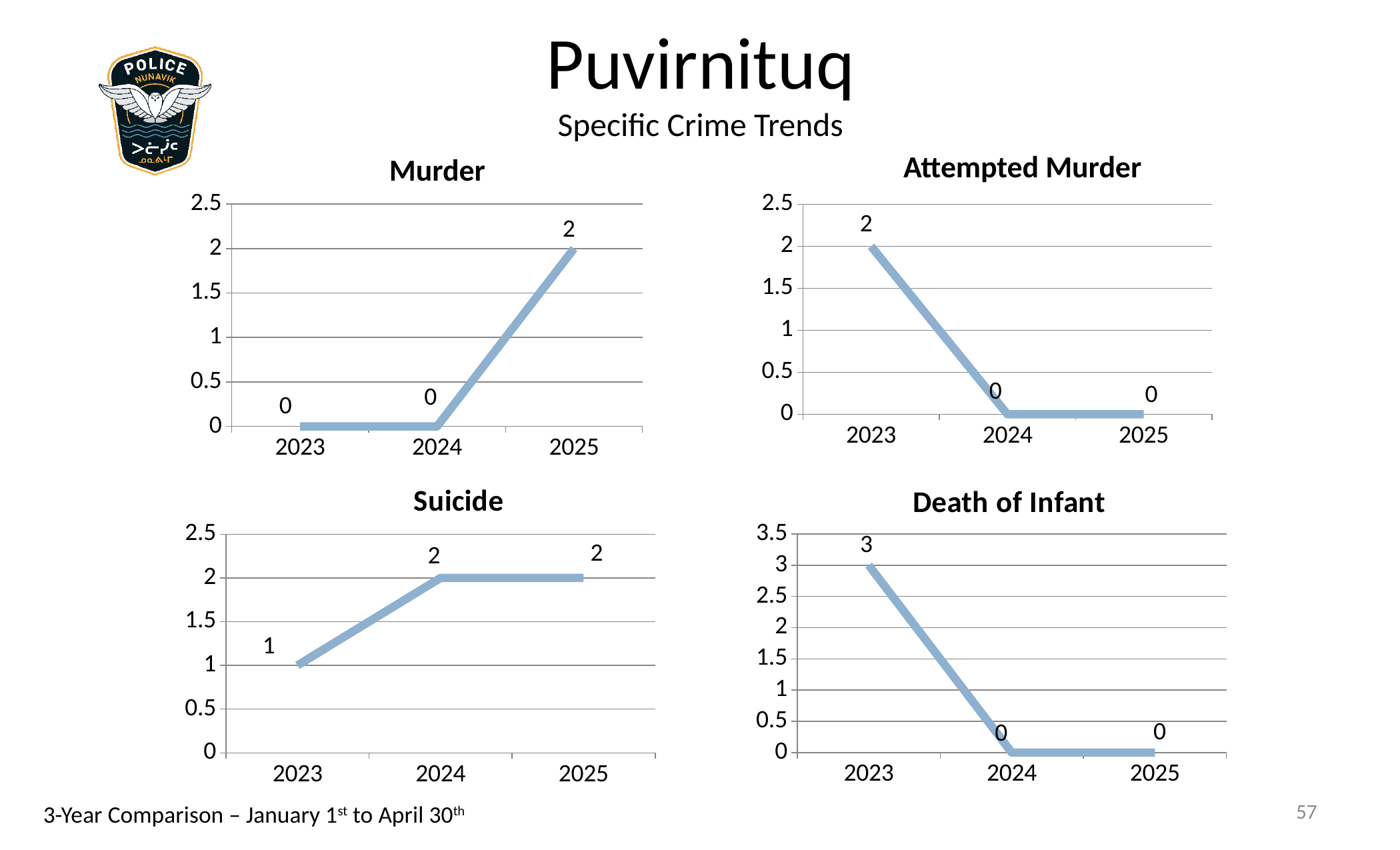
In the Suicide chart, which year has the lowest value? 2023 How many years are plotted in the Suicide chart? 3 In the Murder chart, which year has the larger value, 2024 or 2025? 2025 In the Attempted Murder chart, do the values rise or fall from 2023 to 2025? fall In the Suicide chart, what is the difference between the 2024 and 2023 values? 1 In the Attempted Murder chart, what is the value for 2023? 2 In the Death of Infant chart, what is the value for 2023? 3 In the Death of Infant chart, what is the difference between the 2023 and 2024 values? 3 What kind of chart is the Murder chart? line chart In the Suicide chart, what is the value for 2023? 1 In the Murder chart, what is the value for 2025? 2 In the Death of Infant chart, which year has the highest value? 2023